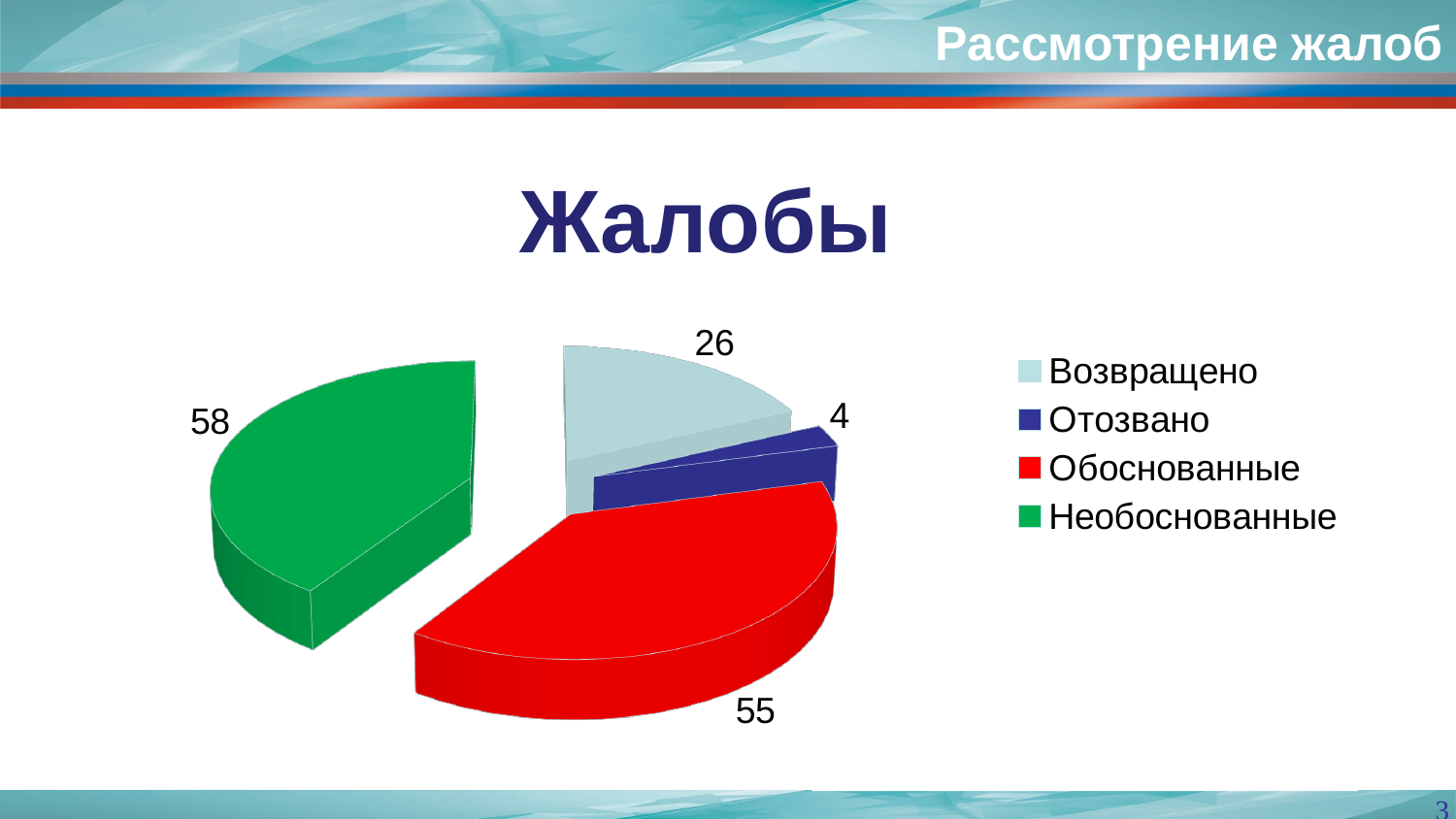
What colour is the slice for Обоснованные? Red What is the value for Обоснованные? 55 What type of chart is shown on the slide? Pie chart What is the difference between the values for Необоснованные and Обоснованные? 3 Which category has the smallest value? Отозвано What is the title of the chart? Жалобы What is the value for Необоснованные? 58 How many categories does the pie chart have? 4 Which is larger, the value for Возвращено or the value for Отозвано? Возвращено What is the value for Отозвано? 4 What is the value for Возвращено? 26 Which category has the largest value? Необоснованные